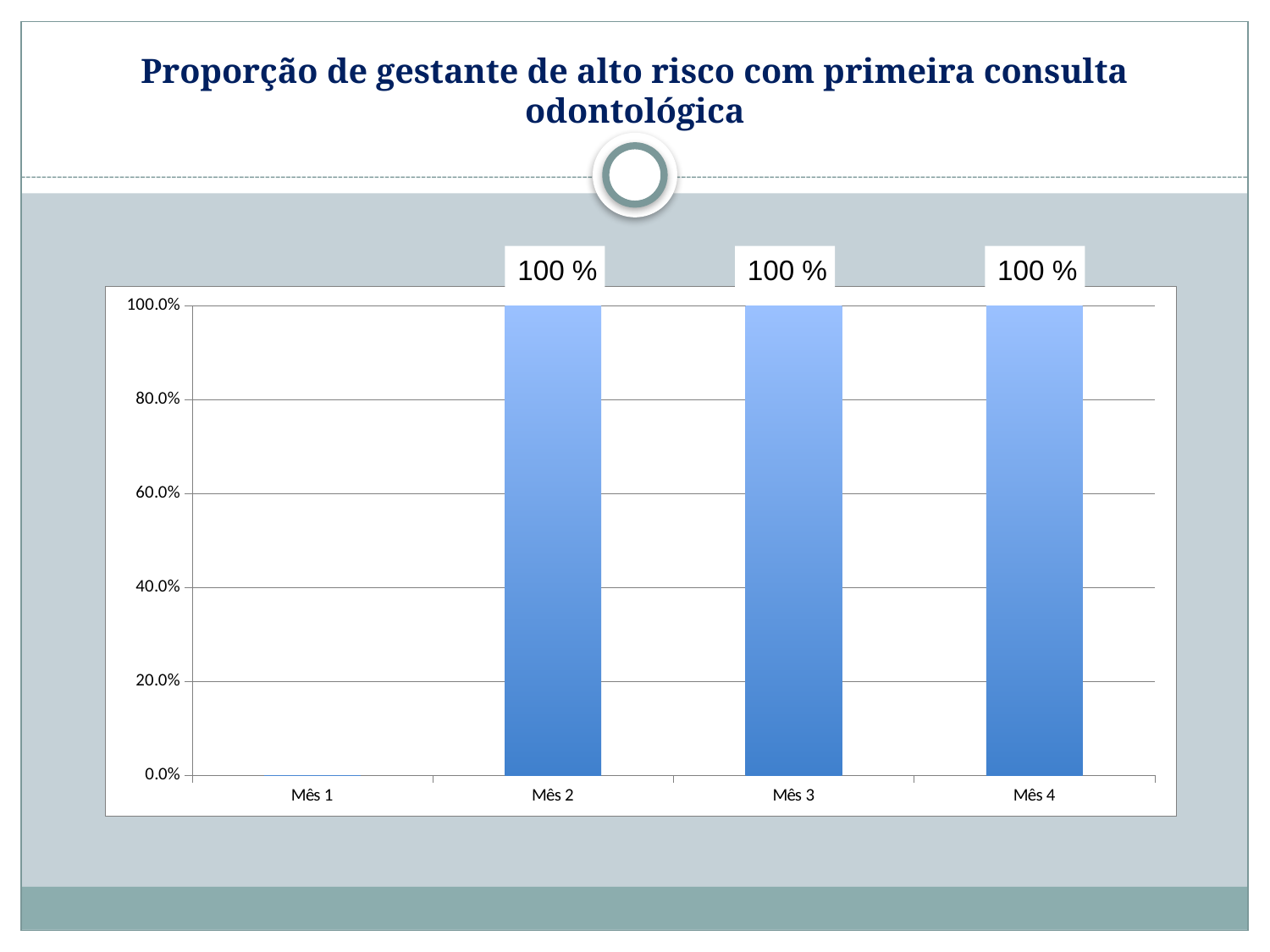
Is the value for Mês 1 greater or less than 20.0%? less What is the value for Mês 3? 100 % Which month has the lowest value? Mês 1 What is the value for Mês 4? 100 % What is the title of the slide? Proporção de gestante de alto risco com primeira consulta odontológica Does the value rise or fall from Mês 1 to Mês 2? rise What is the difference between the values for Mês 2 and Mês 4? 0 % How many months are shown on the x axis? 4 Which is larger, the value for Mês 1 or the value for Mês 2? Mês 2 What kind of chart is shown on the slide? bar chart What is the value for Mês 2? 100 % Is the value for Mês 3 greater or less than 80.0%? greater